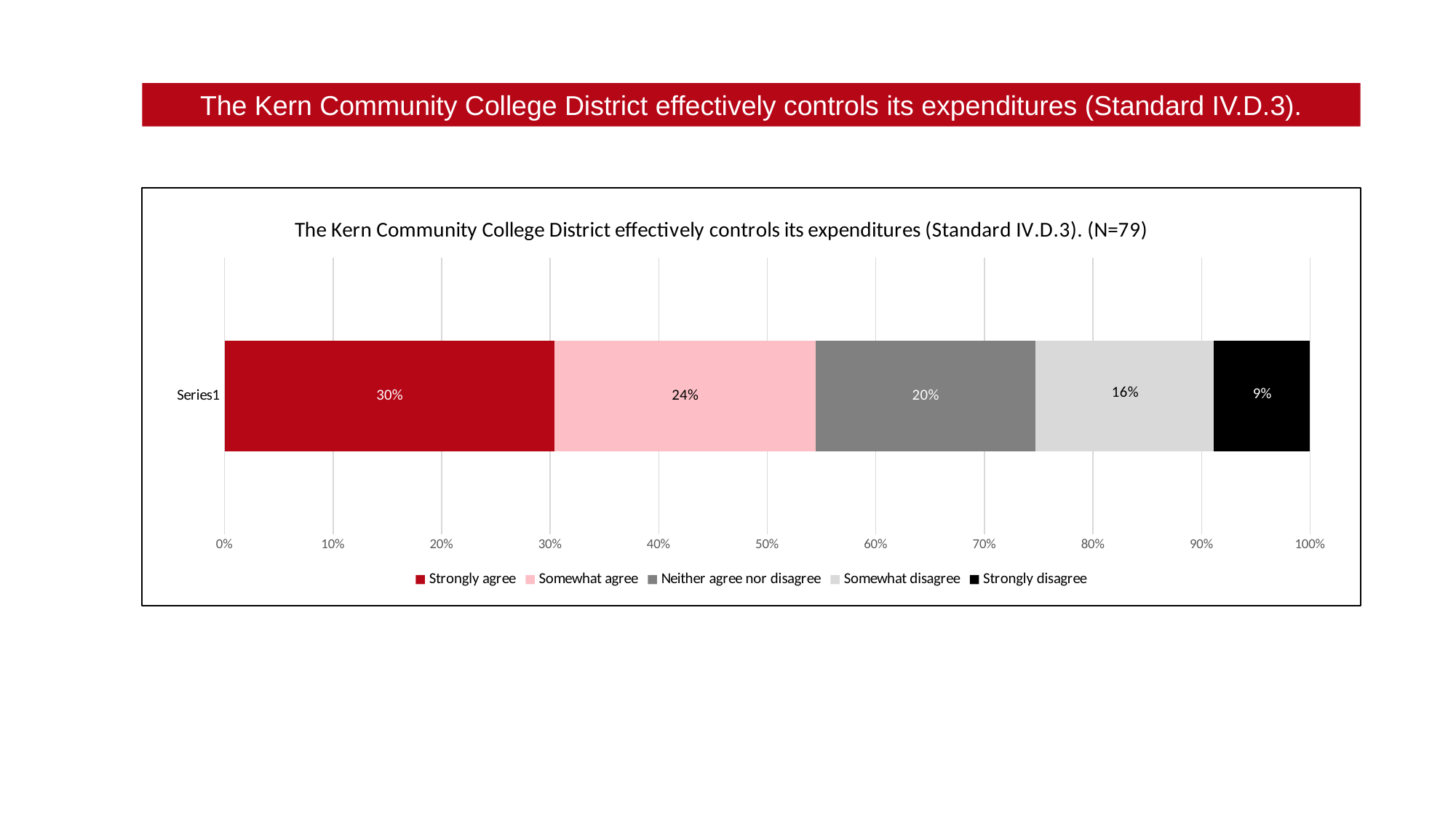
What is the sample size (N) given in the chart title? 79 What is the difference in percentage points between "Strongly agree" and "Strongly disagree"? 21 What percentage of respondents selected "Strongly disagree"? 9% What percentage of respondents selected "Strongly agree"? 30% Which response category has the largest share? Strongly agree Which response category has the smallest share? Strongly disagree How many series does the legend list? 5 What percentage of respondents selected "Neither agree nor disagree"? 20% Which is larger, the share for "Somewhat agree" or the share for "Somewhat disagree"? Somewhat agree What percentage of respondents selected "Somewhat disagree"? 16% What kind of chart is shown on the slide? Stacked bar chart What percentage of respondents selected "Somewhat agree"? 24%